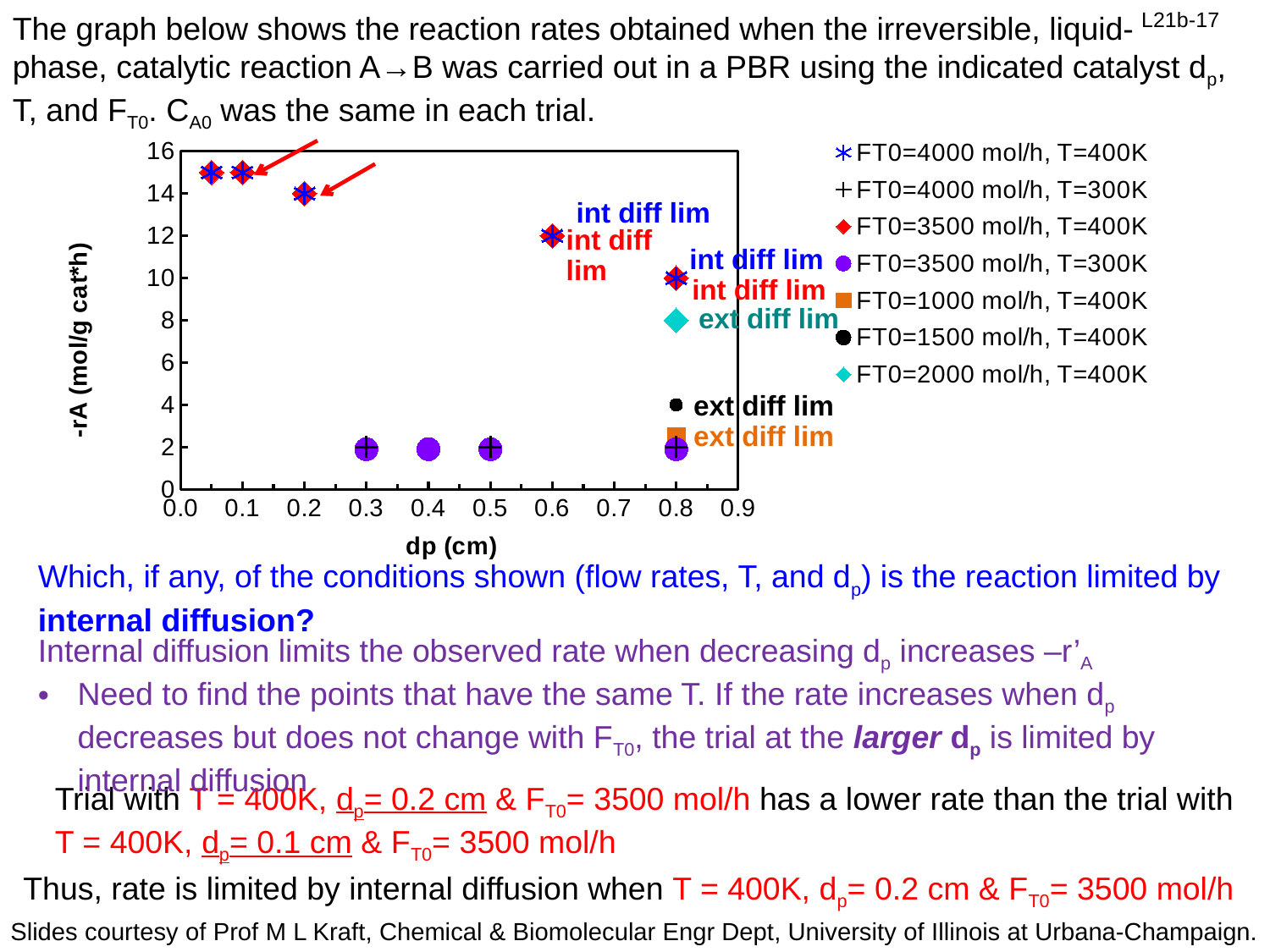
What is the reaction rate -rA at dp = 0.2 cm for FT0=3500 mol/h, T=400K? 14 What is the reaction rate -rA at dp = 0.8 cm for FT0=2000 mol/h, T=400K? 8 What kind of chart is shown on the slide? scatter chart Is the reaction rate at dp = 0.8 cm for FT0=1000 mol/h, T=400K greater or less than 4? less What is the label of the x axis? dp (cm) For FT0=3500 mol/h, T=400K, what is the difference in reaction rate between dp = 0.2 cm and dp = 0.6 cm? 2 How many series does the legend list? 7 What is the label of the y axis? -rA (mol/g cat*h) Is the reaction rate at dp = 0.05 cm for FT0=3500 mol/h, T=400K greater or less than 14? greater What is the reaction rate -rA at dp = 0.6 cm for FT0=3500 mol/h, T=400K? 12 For FT0=3500 mol/h, T=400K, which has the larger reaction rate: dp = 0.6 cm or dp = 0.8 cm? dp = 0.6 cm